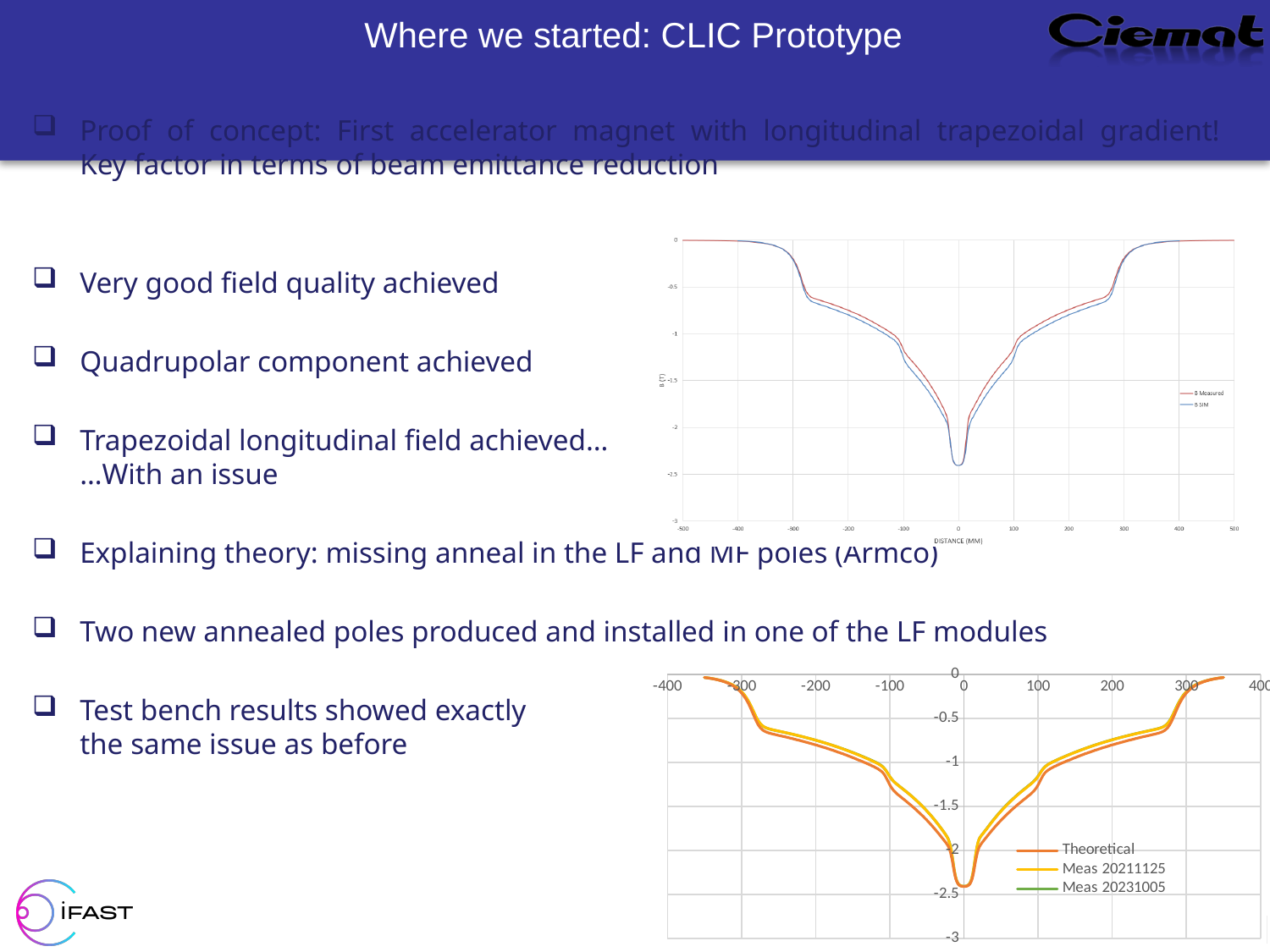
In the bottom chart, which series is drawn in orange according to the legend? Theoretical In the bottom chart, is the Theoretical value at 0 greater or less than -3? greater How many series does the legend of the bottom chart list? 3 What kind of chart is the top chart on the slide? line chart In the bottom chart, do the values rise or fall along the x axis from -400 to 0? fall In the top chart, what are the two series named in the legend? B Measured and B SIM In the top chart, is the value of B Measured at distance 0 greater or less than -2? less In the top chart, do the values rise or fall along the x axis from 0 to 500? rise In the bottom chart, is the Theoretical value at 0 greater or less than -2? less How many series does the legend of the top chart list? 2 In the top chart, what is the label of the x axis? DISTANCE (MM) What kind of chart is the bottom chart on the slide? line chart